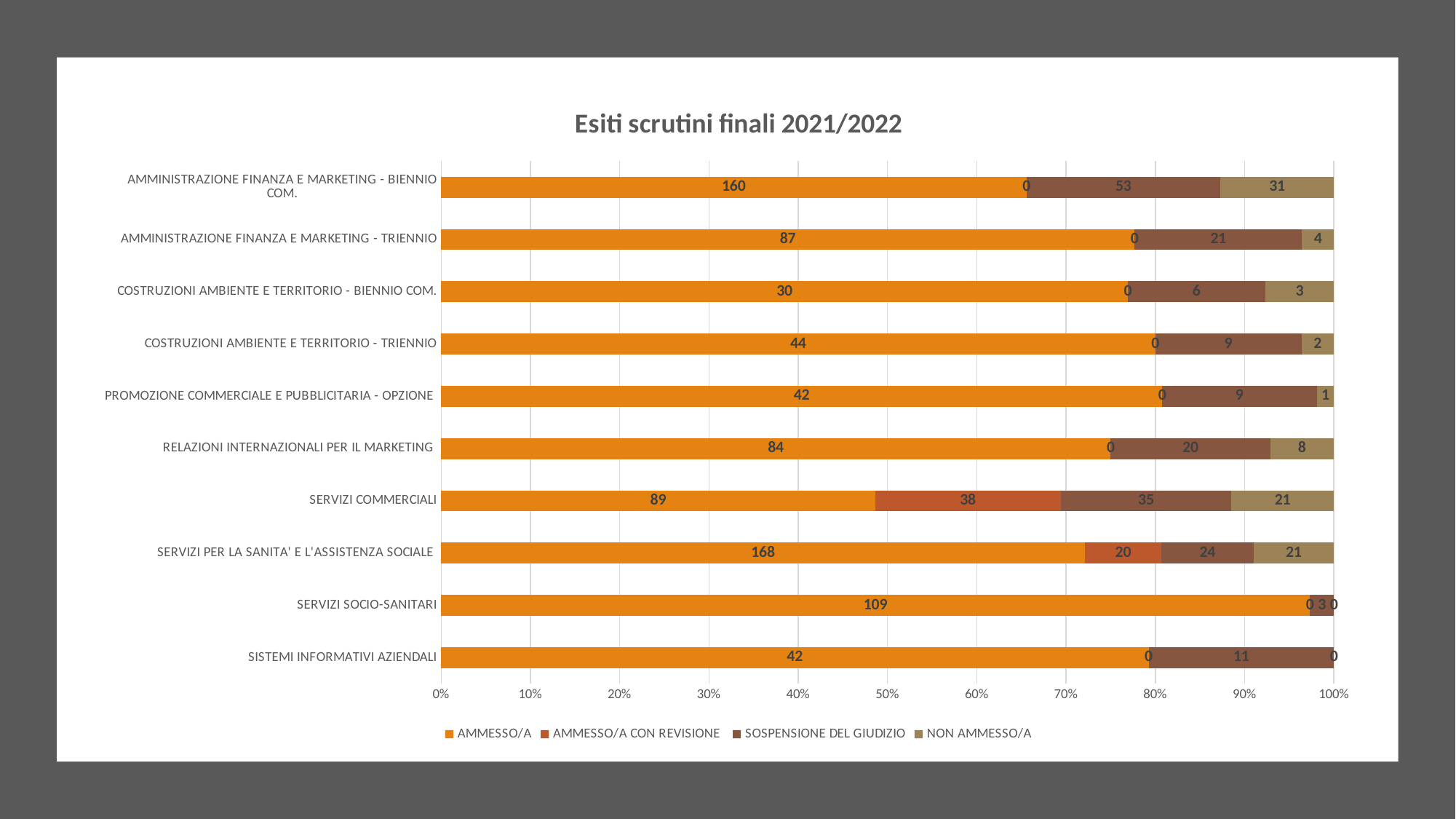
What is the AMMESSO/A value for SERVIZI SOCIO-SANITARI? 109 How many series does the legend list? 4 Is the AMMESSO/A share of the bar for SERVIZI SOCIO-SANITARI greater or less than 90%? greater What is the AMMESSO/A CON REVISIONE value for SERVIZI COMMERCIALI? 38 Which category has the highest AMMESSO/A value? SERVIZI PER LA SANITA' E L'ASSISTENZA SOCIALE What is the title of the chart? Esiti scrutini finali 2021/2022 How many categories (courses) are shown on the chart? 10 Which category has the lowest AMMESSO/A value? COSTRUZIONI AMBIENTE E TERRITORIO - BIENNIO COM. What is the total of all four series for SERVIZI COMMERCIALI? 183 What is the SOSPENSIONE DEL GIUDIZIO value for AMMINISTRAZIONE FINANZA E MARKETING - BIENNIO COM.? 53 What is the difference between the AMMESSO/A values for AMMINISTRAZIONE FINANZA E MARKETING - BIENNIO COM. and AMMINISTRAZIONE FINANZA E MARKETING - TRIENNIO? 73 What type of chart is shown on the slide? Stacked bar chart